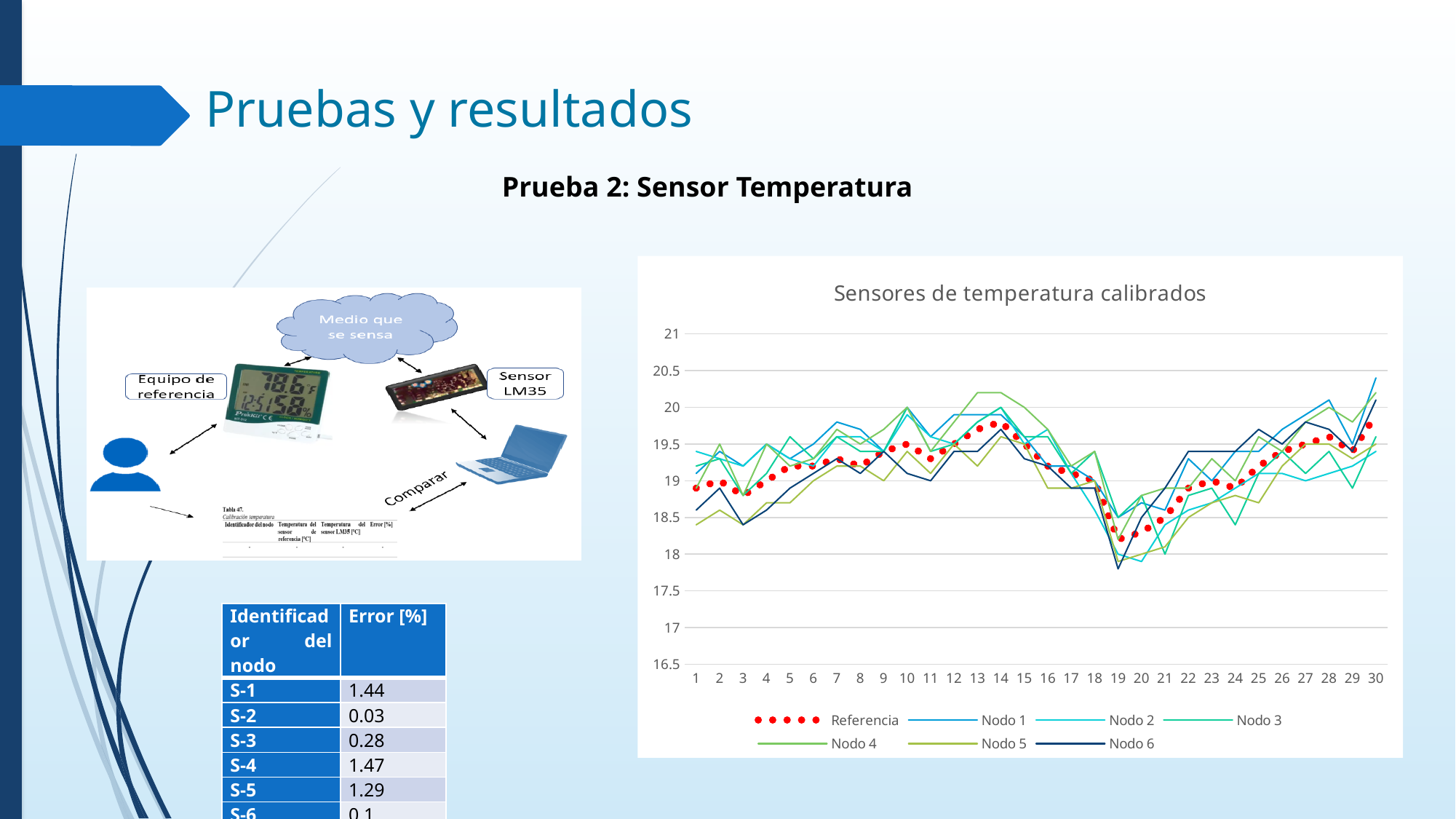
How many points are plotted along the x axis of the chart? 30 Which series reaches the lowest value anywhere on the chart? Nodo 6 Does the Referencia series rise or fall between point 14 and point 19? fall Is the Nodo 6 value at point 19 greater or less than 18? less What is the title of the chart on the slide? Sensores de temperatura calibrados What kind of chart is shown on the slide? line chart Is the Nodo 1 value at point 30 greater or less than 20? greater Which series in the chart is drawn as a dotted red line? Referencia How many series does the chart's legend list? 7 Is the Referencia value at point 14 greater or less than 19.5? greater Does the Referencia series rise or fall between point 19 and point 30? rise